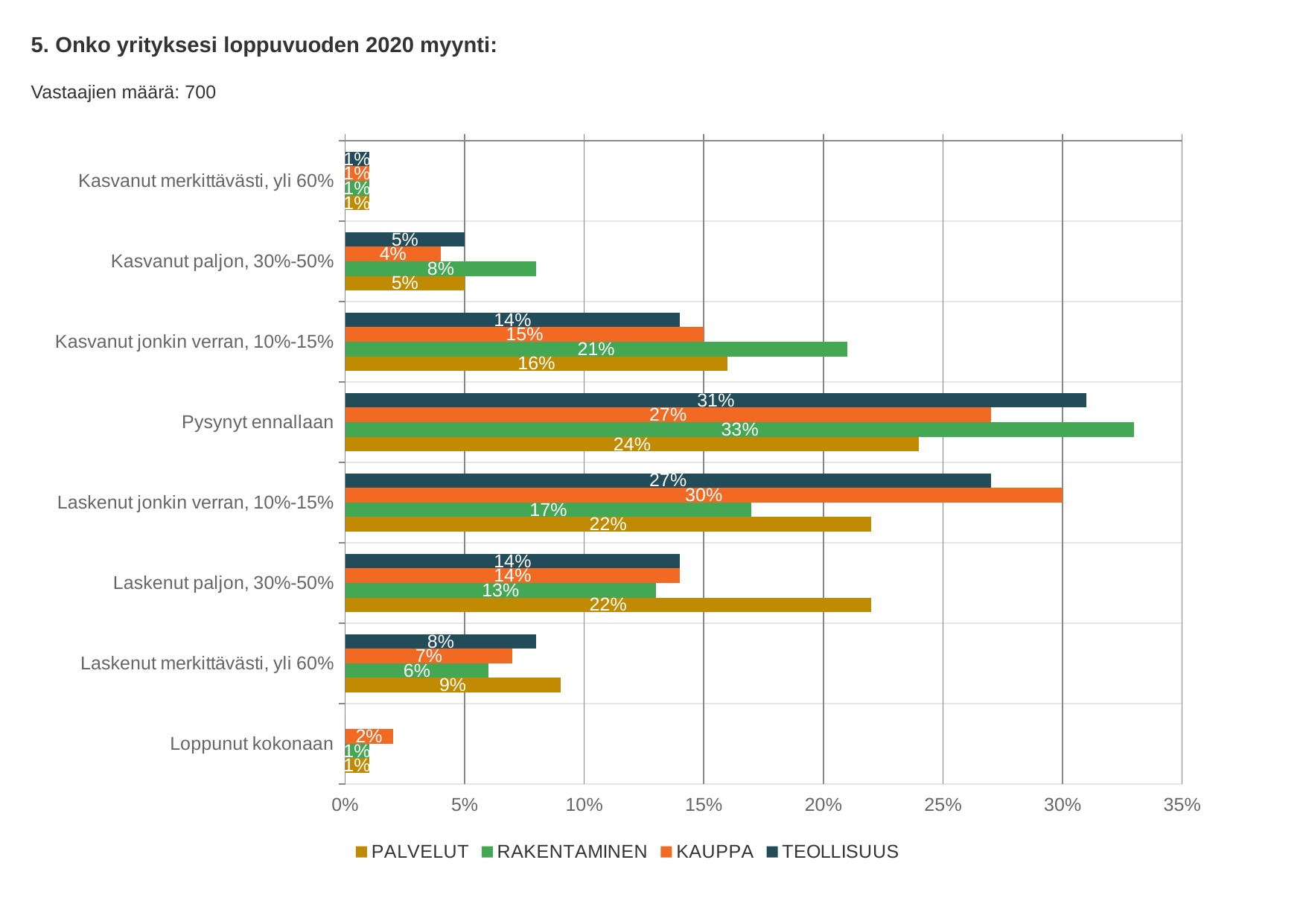
What is the value for RAKENTAMINEN in the category "Pysynyt ennallaan"? 33% What is the value for TEOLLISUUS in the category "Kasvanut jonkin verran, 10%-15%"? 14% What is the value for PALVELUT in the category "Laskenut paljon, 30%-50%"? 22% In the category "Laskenut jonkin verran, 10%-15%", which is larger: the value for KAUPPA or the value for RAKENTAMINEN? KAUPPA Which category has the highest value for TEOLLISUUS? Pysynyt ennallaan What kind of chart is shown on the slide? bar chart How many series does the legend list? 4 Is the value for TEOLLISUUS in the category "Pysynyt ennallaan" greater or less than 30%? greater What is the difference between the RAKENTAMINEN and PALVELUT values in the category "Pysynyt ennallaan"? 9% What is the value for KAUPPA in the category "Laskenut jonkin verran, 10%-15%"? 30% Which series has the lowest value in the category "Pysynyt ennallaan"? PALVELUT How many categories are shown on the y axis of the chart? 8